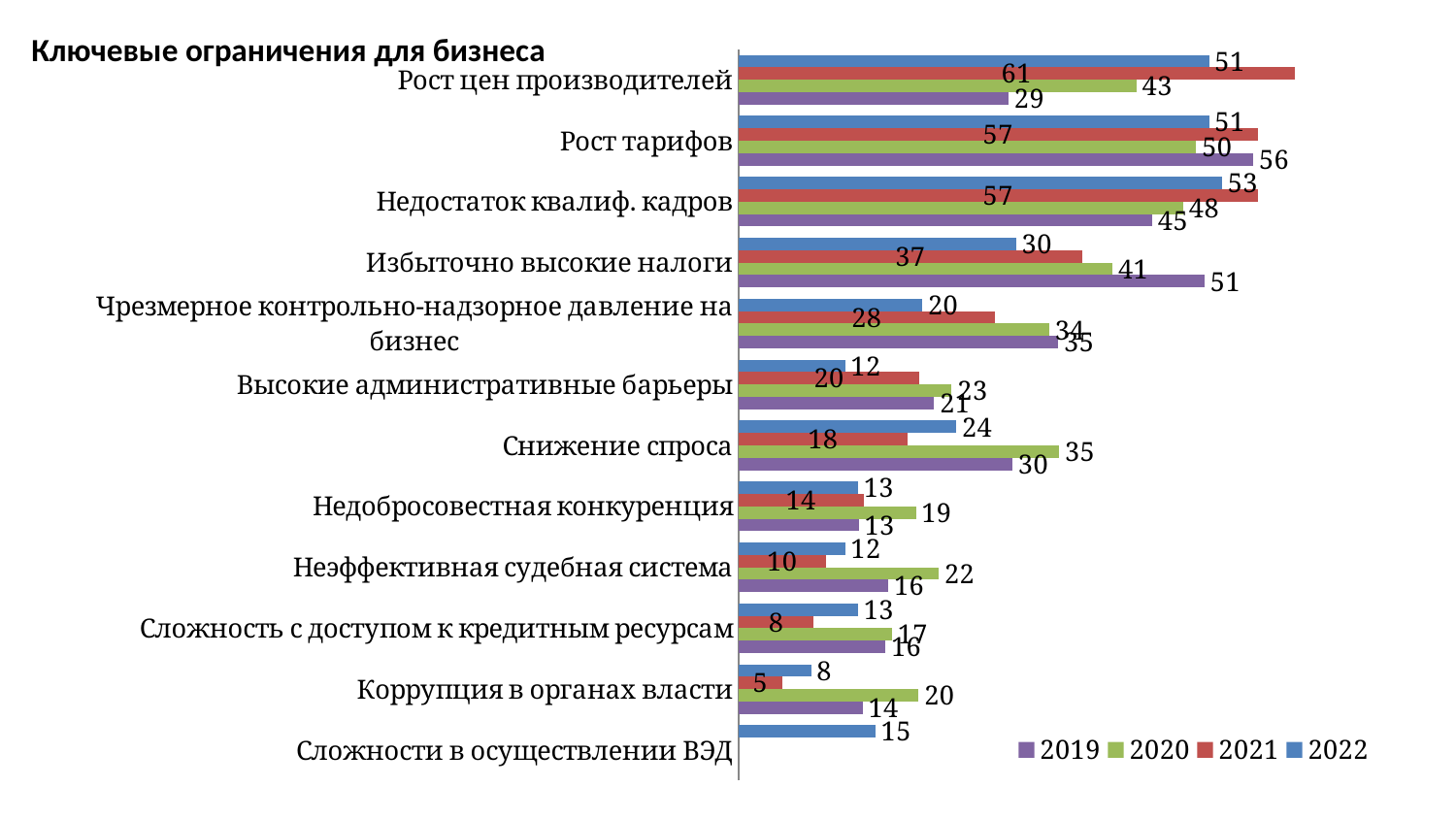
For 'Снижение спроса', which is larger: the 2020 value or the 2022 value? 2020 What is the value for 'Коррупция в органах власти' in 2021? 5 What is the title of the chart? Ключевые ограничения для бизнеса Which category has the highest value in the 2021 series? Рост цен производителей What is the value for 'Избыточно высокие налоги' in 2019? 51 Which category has the lowest value in the 2022 series? Коррупция в органах власти What type of chart is shown on the slide? bar chart What is the value for 'Сложности в осуществлении ВЭД' in 2022? 15 How many categories are shown on the chart? 12 What is the difference between the 2021 and 2019 values for 'Рост цен производителей'? 32 What is the value for 'Рост цен производителей' in 2021? 61 How many series does the legend list? 4